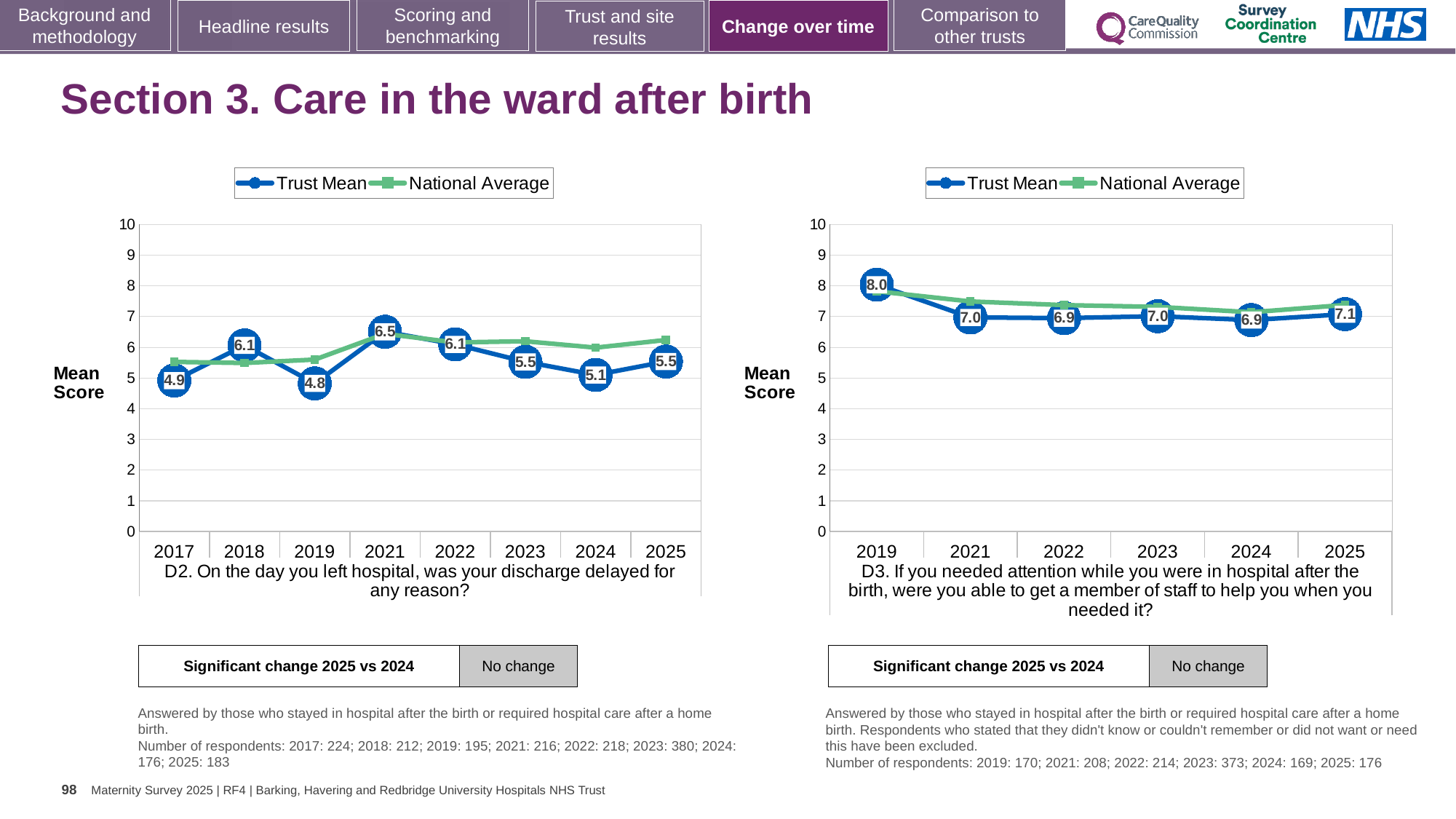
In the D3 chart (right), what is the difference between the Trust Mean for 2019 and the Trust Mean for 2025? 0.9 How many series does the legend of the D3 chart (right) list? 2 In the D3 chart (right), what is the Trust Mean for 2019? 8.0 What kind of chart is the D2 chart (left)? Line chart How many years are plotted on the x axis of the D2 chart (left)? 8 In the D2 chart (left), which year has the lowest Trust Mean? 2019 In the D3 chart (right), which year has the highest Trust Mean? 2019 In the D2 chart (left), which is larger: the Trust Mean for 2018 or the Trust Mean for 2024? 2018 In the D2 chart (left), what is the Trust Mean for 2021? 6.5 In the D3 chart (right), is the National Average for 2019 greater or less than 7? greater In the D2 chart (left), what is the difference between the Trust Mean for 2021 and the Trust Mean for 2019? 1.7 In the D3 chart (right), does the Trust Mean rise or fall from 2019 to 2021? Fall